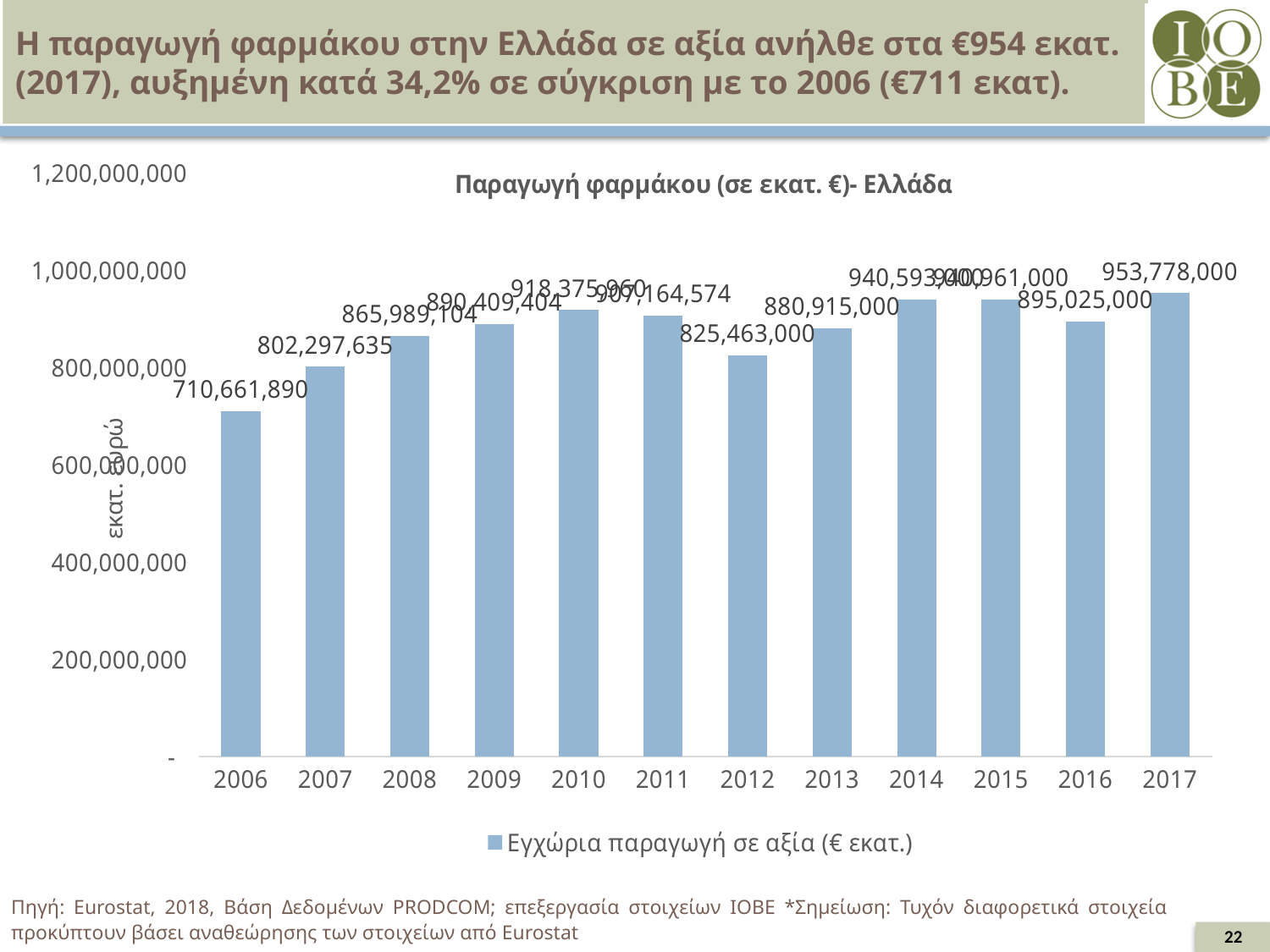
What is the value for 2017? 953,778,000 Is the value for 2006 greater or less than 800,000,000? less What is the difference between the values for 2017 and 2006? 243,116,110 What is the value for 2016? 895,025,000 What is the difference between the values for 2013 and 2012? 55,452,000 What is the value for 2012? 825,463,000 How many years are shown on the x axis? 12 What kind of chart is this? bar chart Which is larger, the value for 2012 or the value for 2013? 2013 Which year has the highest value? 2017 What is the value for 2006? 710,661,890 Which year has the lowest value? 2006